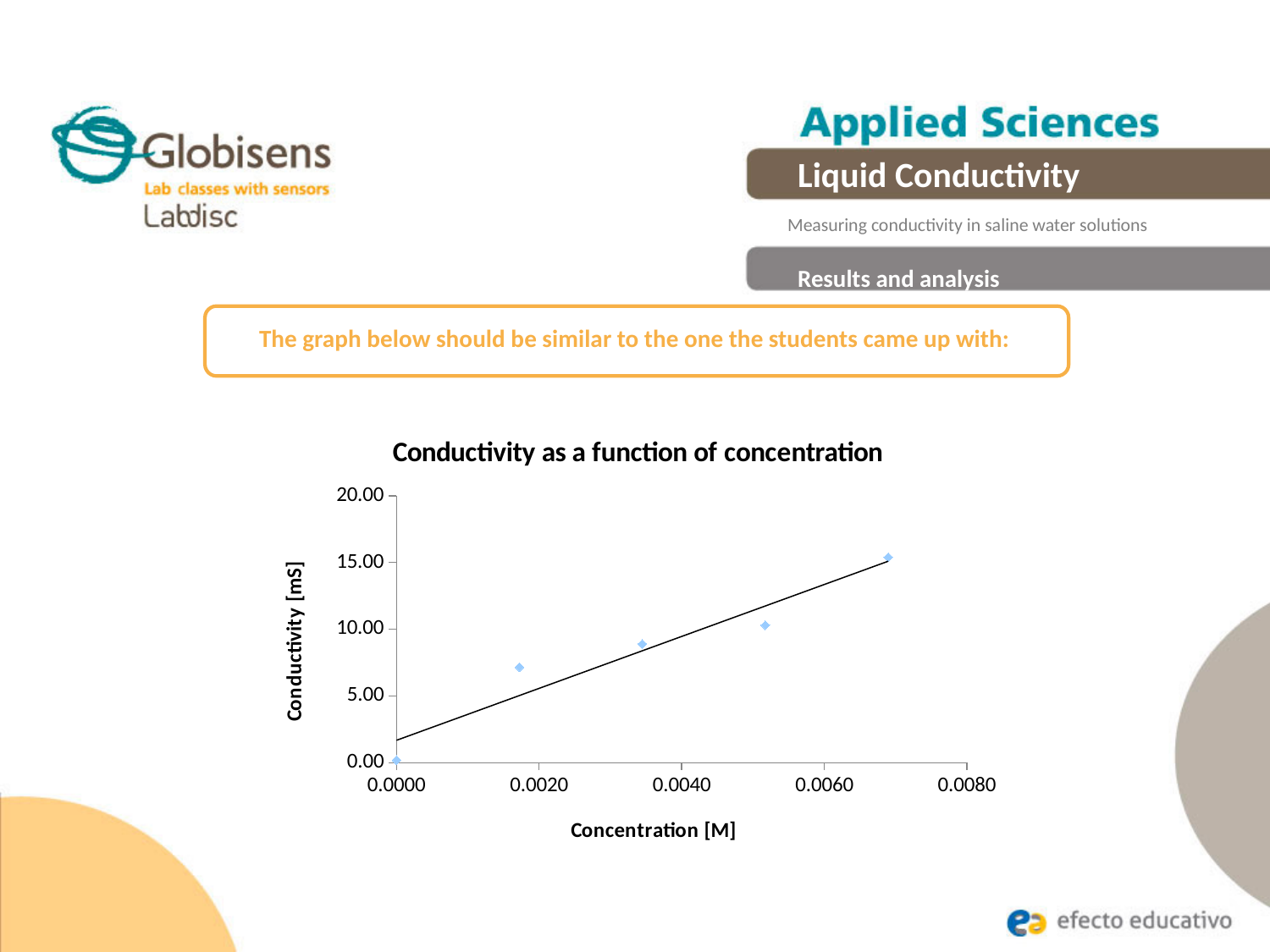
Is the conductivity of the point near 0.0020 M greater or less than 5.00 mS? greater At which concentration does the chart show the lowest conductivity? 0.0000 How many data points are plotted on the chart? 5 What kind of chart is shown on the slide? Scatter chart Which plotted point has the highest conductivity: the one near 0.0052 M or the one near 0.0069 M? The one near 0.0069 M Is the conductivity of the point near 0.0035 M greater or less than 10.00 mS? less Does conductivity rise or fall as concentration increases along the x axis? Rise What is the label of the vertical axis of the chart? Conductivity [mS] What is the title of the chart? Conductivity as a function of concentration Is the conductivity of the point with the highest concentration greater or less than 20.00 mS? less